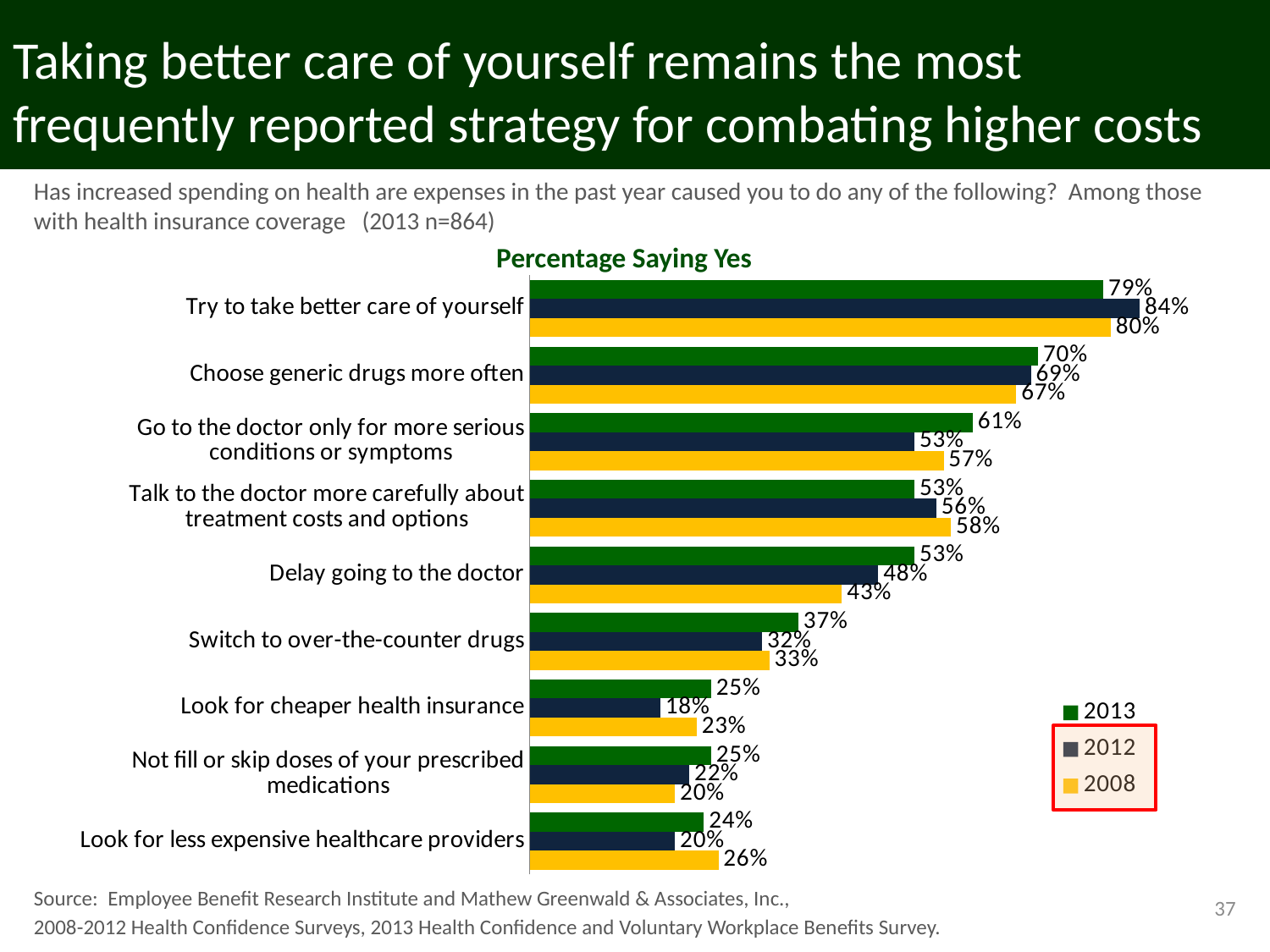
What is the 2008 value for 'Delay going to the doctor'? 43% What is the difference between the 2013 and 2008 values for 'Delay going to the doctor'? 10 percentage points What is the 2013 value for 'Go to the doctor only for more serious conditions or symptoms'? 61% What percentage said yes to 'Try to take better care of yourself' in 2012? 84% Which series is shown in yellow in the legend? 2008 Which strategy has the highest 2013 value? Try to take better care of yourself For 'Talk to the doctor more carefully about treatment costs and options', which year has the larger value, 2013 or 2008? 2008 What kind of chart is shown on the slide? Bar chart Which strategy has the lowest 2012 value? Look for cheaper health insurance How many strategies (categories) are plotted on the chart? 9 What is the difference between the 2013 and 2012 values for 'Look for cheaper health insurance'? 7 percentage points How many series does the legend list? 3